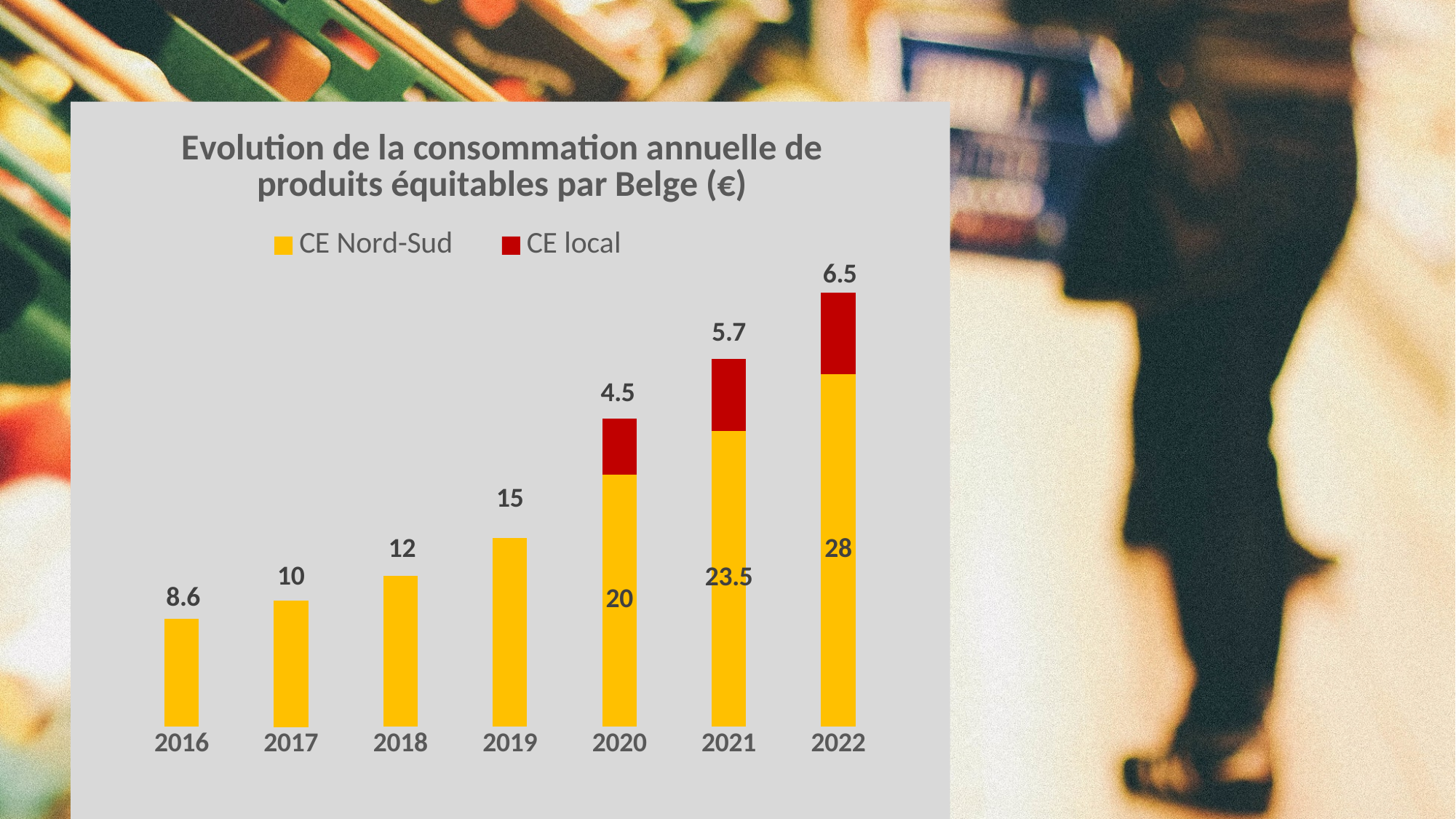
What kind of chart is shown? Stacked bar chart How many series does the legend list? 2 What is the difference between the CE Nord-Sud values for 2022 and 2021? 4.5 What is the total of the stacked bar for 2020? 24.5 What is the CE Nord-Sud value for 2016? 8.6 How many years are shown on the x axis? 7 Which year has the highest CE Nord-Sud value? 2022 What is the CE local value for 2021? 5.7 Which is larger, the CE local value for 2020 or for 2022? 2022 What is the CE Nord-Sud value for 2022? 28 Which year has the lowest CE Nord-Sud value? 2016 Do the CE Nord-Sud values rise or fall from 2016 to 2022? Rise